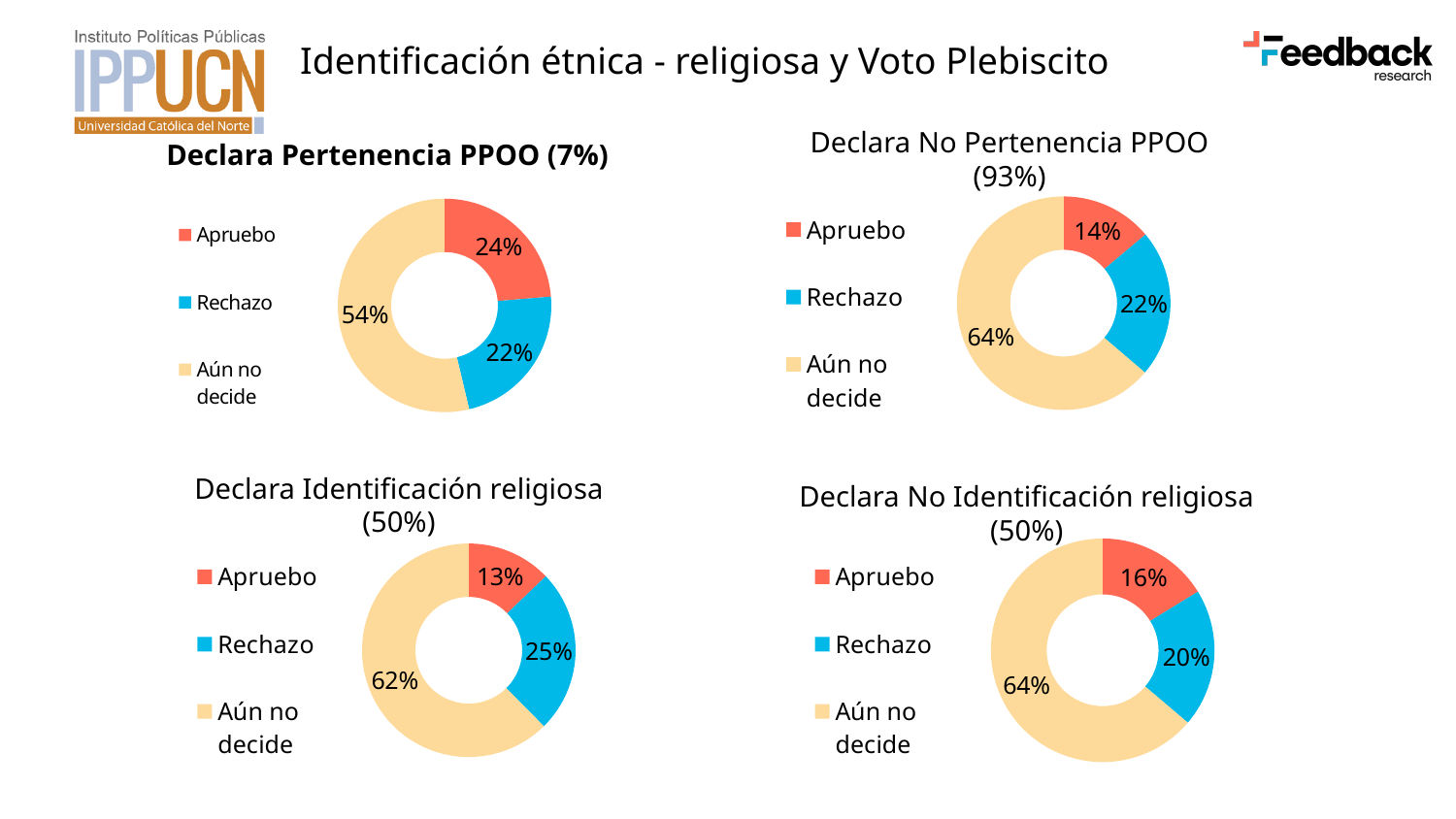
In the 'Declara Identificación religiosa (50%)' chart, what percentage is shown for Aún no decide? 62% In the 'Declara Pertenencia PPOO (7%)' chart, what is the combined share of Apruebo and Rechazo? 46% In the 'Declara Pertenencia PPOO (7%)' chart, which category has the largest share? Aún no decide In the 'Declara No Identificación religiosa (50%)' chart, which is larger, Rechazo or Apruebo? Rechazo In the 'Declara No Identificación religiosa (50%)' chart, what percentage is shown for Apruebo? 16% In the 'Declara No Pertenencia PPOO (93%)' chart, which colour represents Aún no decide? Light yellow In the 'Declara No Pertenencia PPOO (93%)' chart, what is the difference between Aún no decide and Rechazo? 42% What kind of chart is the 'Declara Identificación religiosa (50%)' chart? Doughnut chart In the 'Declara Pertenencia PPOO (7%)' chart, what percentage is shown for Apruebo? 24% In the 'Declara No Pertenencia PPOO (93%)' chart, what percentage is shown for Rechazo? 22% How many categories does the 'Declara Pertenencia PPOO (7%)' chart show? 3 In the 'Declara Identificación religiosa (50%)' chart, which category has the smallest share? Apruebo